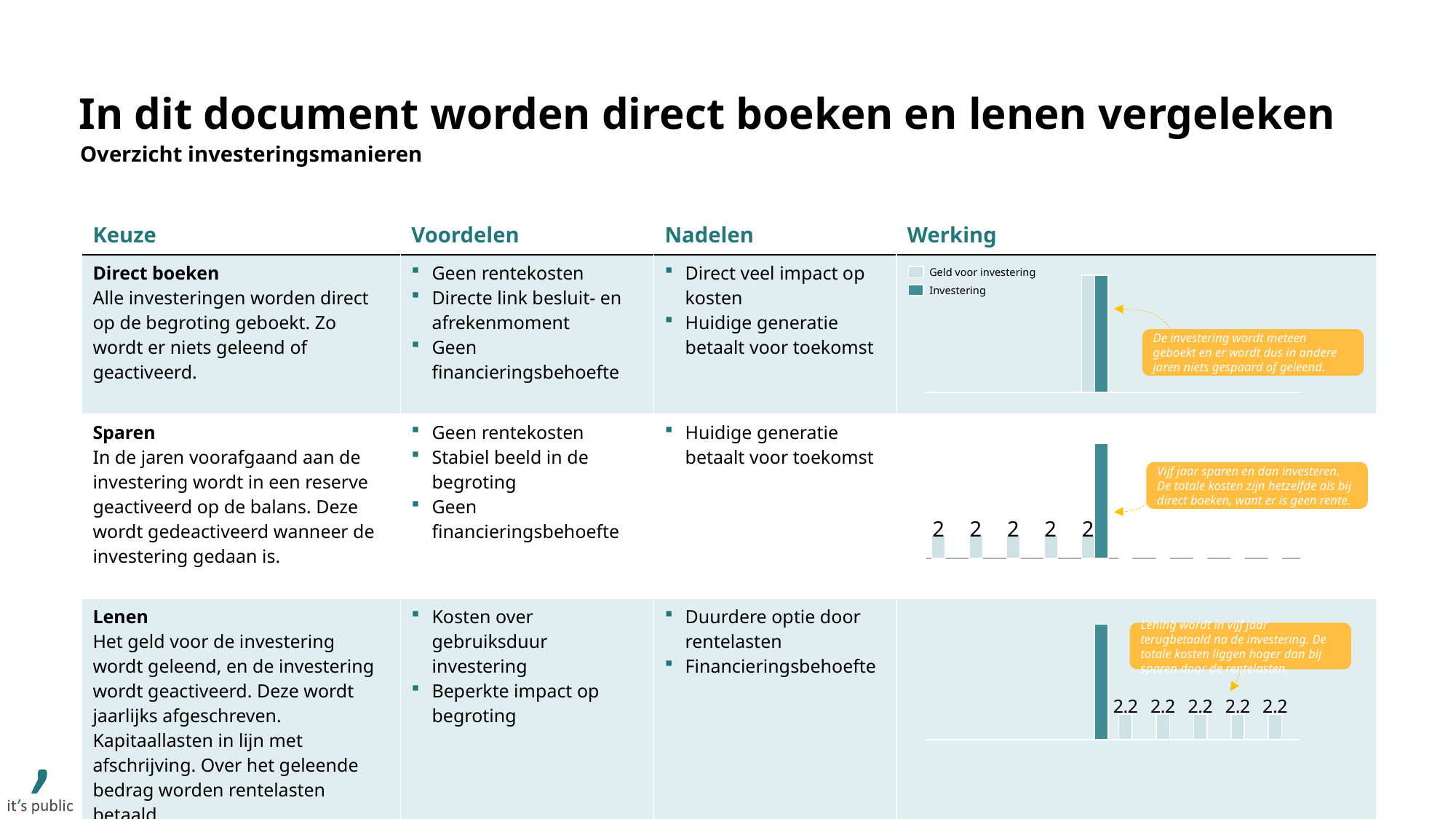
Which is larger: the yearly amount labelled in the Lenen chart or the yearly amount labelled in the Sparen chart? Lenen What kind of chart is shown in the Werking column for Sparen? bar chart How many series does the legend in the Direct boeken chart list? 2 In the Sparen chart, what is the total of the five labelled bars? 10 In the Sparen chart, what value is printed above each of the small 'Geld voor investering' bars? 2 In the Lenen chart, how many bars are labelled with a value? 5 In the Lenen chart, what is the total of the five labelled bars? 11 What is the difference between the yearly amount labelled in the Lenen chart (2.2) and the yearly amount labelled in the Sparen chart (2)? 0.2 In the Lenen chart, what value is printed above each of the small bars? 2.2 In the Sparen chart, how many bars are labelled with a value? 5 In the Sparen chart, do the labelled values rise, fall or stay the same across the years? stay the same What are the two legend entries shown in the Direct boeken chart? Geld voor investering, Investering